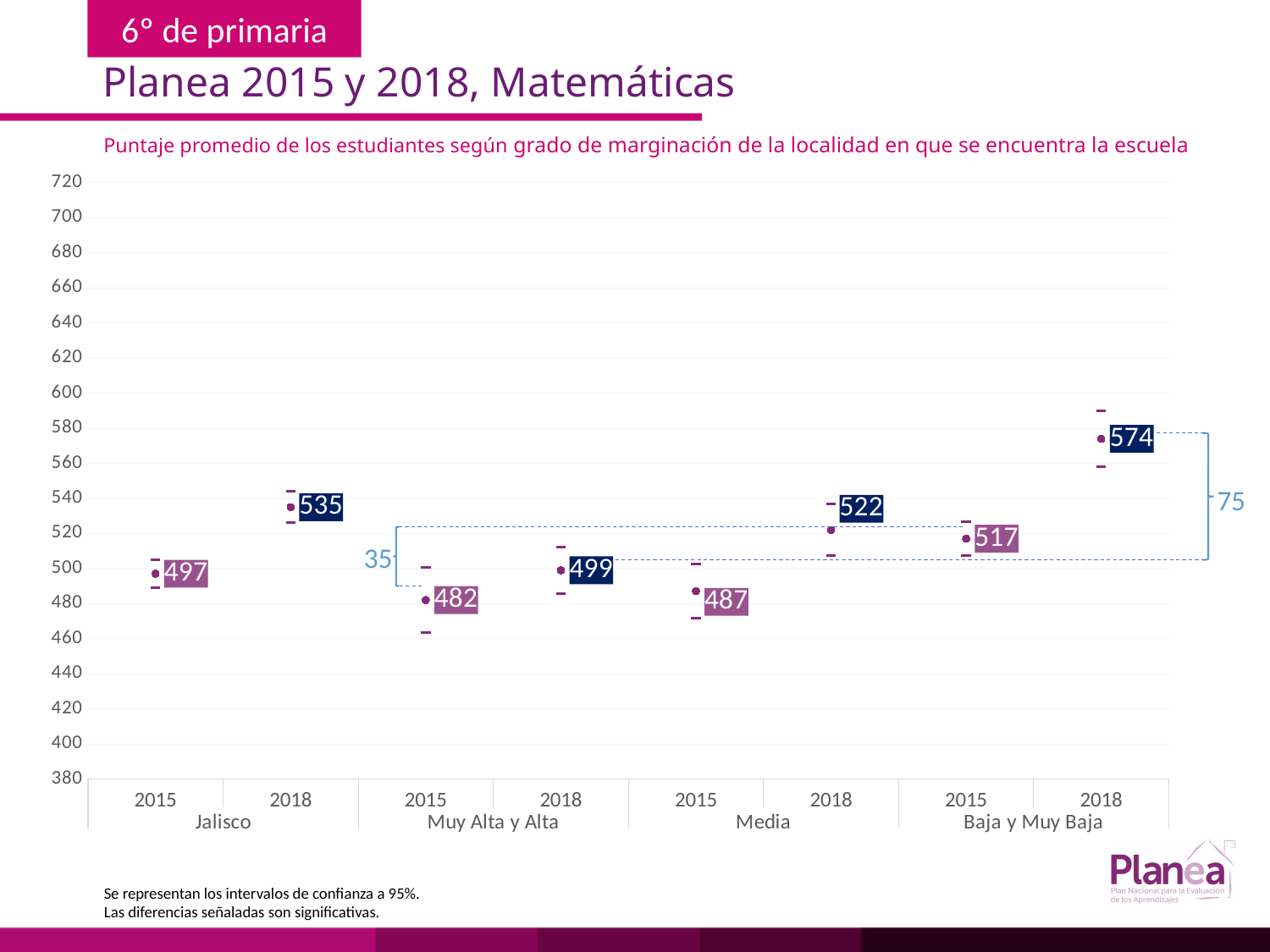
What is the average score for Muy Alta y Alta in 2015? 482 How many data points are plotted on the chart? 8 What is the average score for Jalisco in 2018? 535 What is the average score for Jalisco in 2015? 497 What is the difference between the 2018 scores of Baja y Muy Baja and Muy Alta y Alta? 75 Do the scores rise or fall from 2015 to 2018 within each marginalization group? rise What is the difference between the 2018 and 2015 scores for Jalisco? 38 Which group and year has the lowest average score? Muy Alta y Alta, 2015 What is the average score for Media in 2018? 522 What is the average score for Baja y Muy Baja in 2018? 574 Which group and year has the highest average score? Baja y Muy Baja, 2018 Which is larger, the 2015 score for Media or the 2015 score for Baja y Muy Baja? Baja y Muy Baja